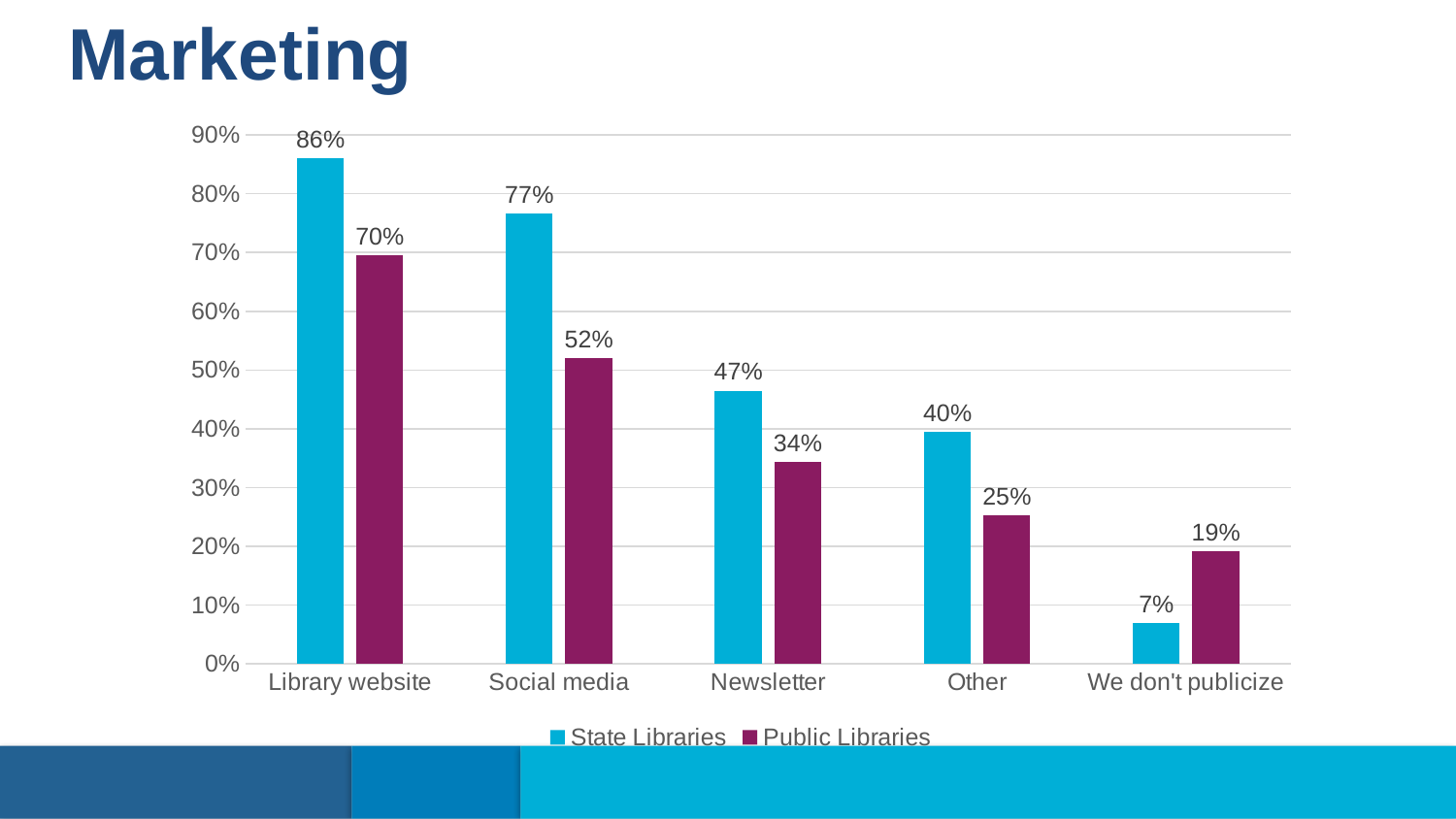
What is the title of the slide? Marketing How many series does the legend list? 2 Which category has the lowest value for State Libraries? We don't publicize What is the difference between State Libraries and Public Libraries for Social media? 25% What is the value for Public Libraries for Social media? 52% What is the value for Public Libraries for We don't publicize? 19% What kind of chart is shown on the slide? Bar chart How many categories are shown on the x axis? 5 Which is larger for Newsletter: State Libraries or Public Libraries? State Libraries Which category has the highest value for Public Libraries? Library website Which is larger for We don't publicize: State Libraries or Public Libraries? Public Libraries What is the value for State Libraries for Library website? 86%